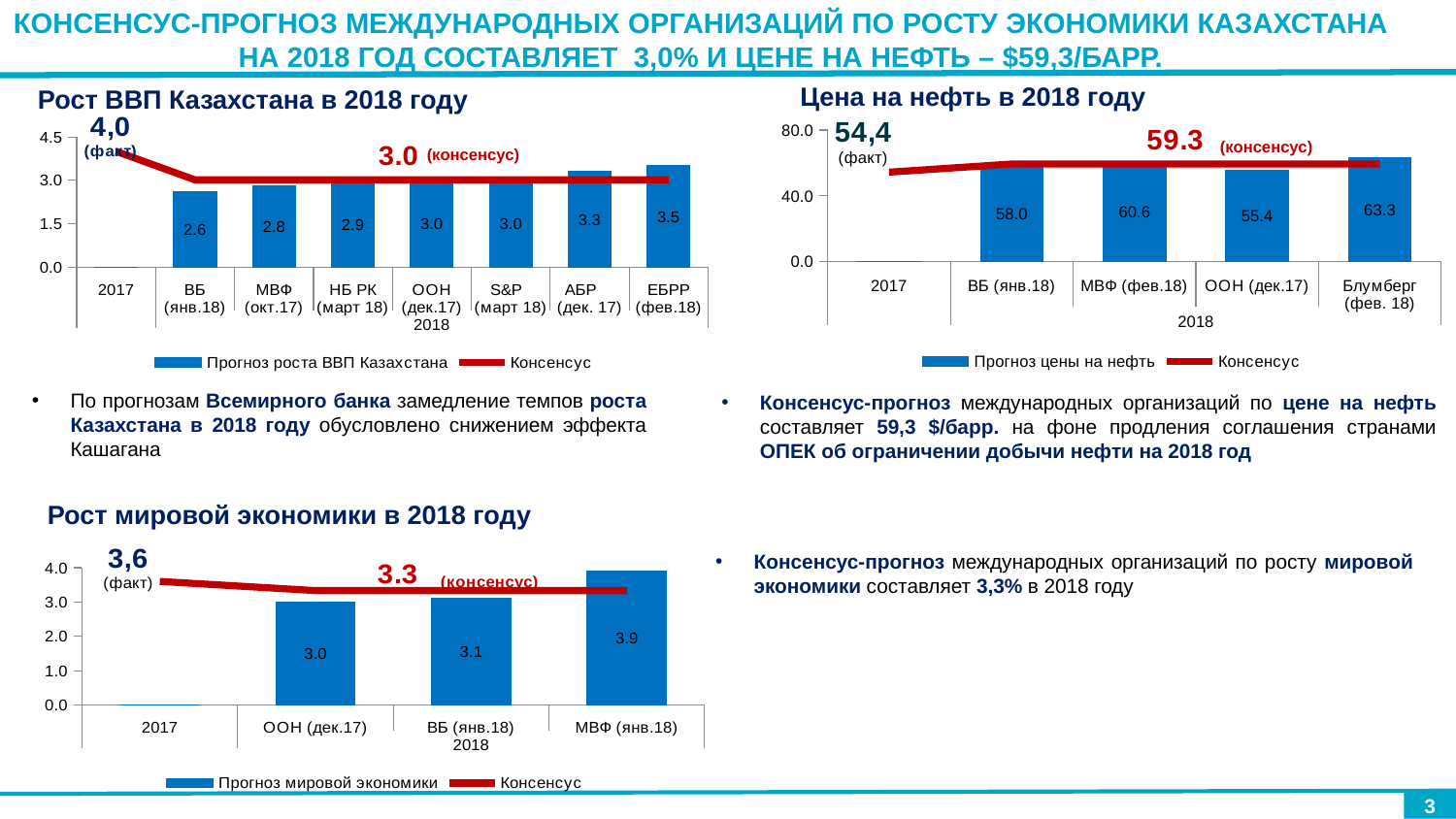
What type of chart is 'Рост мировой экономики в 2018 году'? Bar chart with a line In the chart 'Цена на нефть в 2018 году', which forecaster has the highest forecast? Блумберг (фев. 18) In the chart 'Рост мировой экономики в 2018 году', what is the difference between the МВФ (янв.18) forecast and the ООН (дек.17) forecast? 0.9 In the chart 'Цена на нефть в 2018 году', is the forecast for ООН (дек.17) larger or smaller than the forecast for ВБ (янв.18)? smaller In the chart 'Рост ВВП Казахстана в 2018 году', what is the forecast value for ЕБРР (фев.18)? 3.5 In the chart 'Рост ВВП Казахстана в 2018 году', how many forecast bars are shown for 2018? 7 In the chart 'Рост ВВП Казахстана в 2018 году', which forecaster has the lowest forecast? ВБ (янв.18) In the chart 'Цена на нефть в 2018 году', what is the consensus value shown? 59.3 In the chart 'Рост мировой экономики в 2018 году', what is the forecast value for МВФ (янв.18)? 3.9 How many series does the legend of the chart 'Цена на нефть в 2018 году' list? 2 In the chart 'Цена на нефть в 2018 году', what is the forecast value for МВФ (фев.18)? 60.6 In the chart 'Рост ВВП Казахстана в 2018 году', what is the difference between the ЕБРР (фев.18) forecast and the ВБ (янв.18) forecast? 0.9